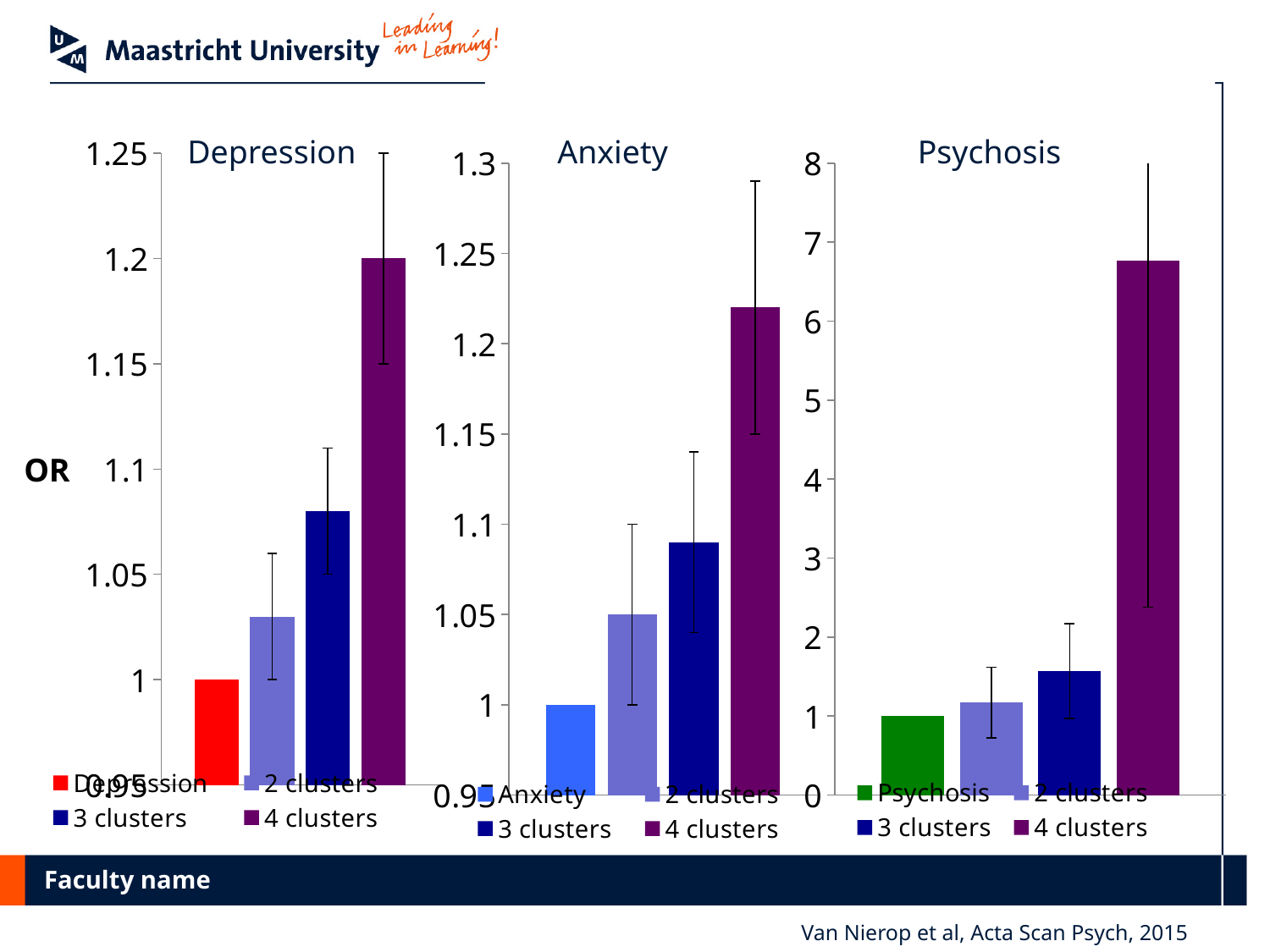
In the Depression chart, is the value for 3 clusters greater or less than 1.05? greater In the Psychosis chart, which bar is the lowest? Psychosis What kind of chart is the Depression chart? bar chart In the Anxiety chart, what is the value of the Anxiety bar? 1 In the Anxiety chart, which is larger, the value for 2 clusters or the value for 3 clusters? 3 clusters In the Psychosis chart, do the bar values rise or fall from left to right? rise In the Psychosis chart, is the value for 4 clusters greater or less than 6? greater In the Anxiety chart, is the value for 4 clusters greater or less than 1.2? greater How many entries does the legend of the Anxiety chart list? 4 In the Depression chart, which bar is the highest? 4 clusters In the Psychosis chart, what is the value of the Psychosis bar? 1 In the Depression chart, what is the value of the Depression bar? 1